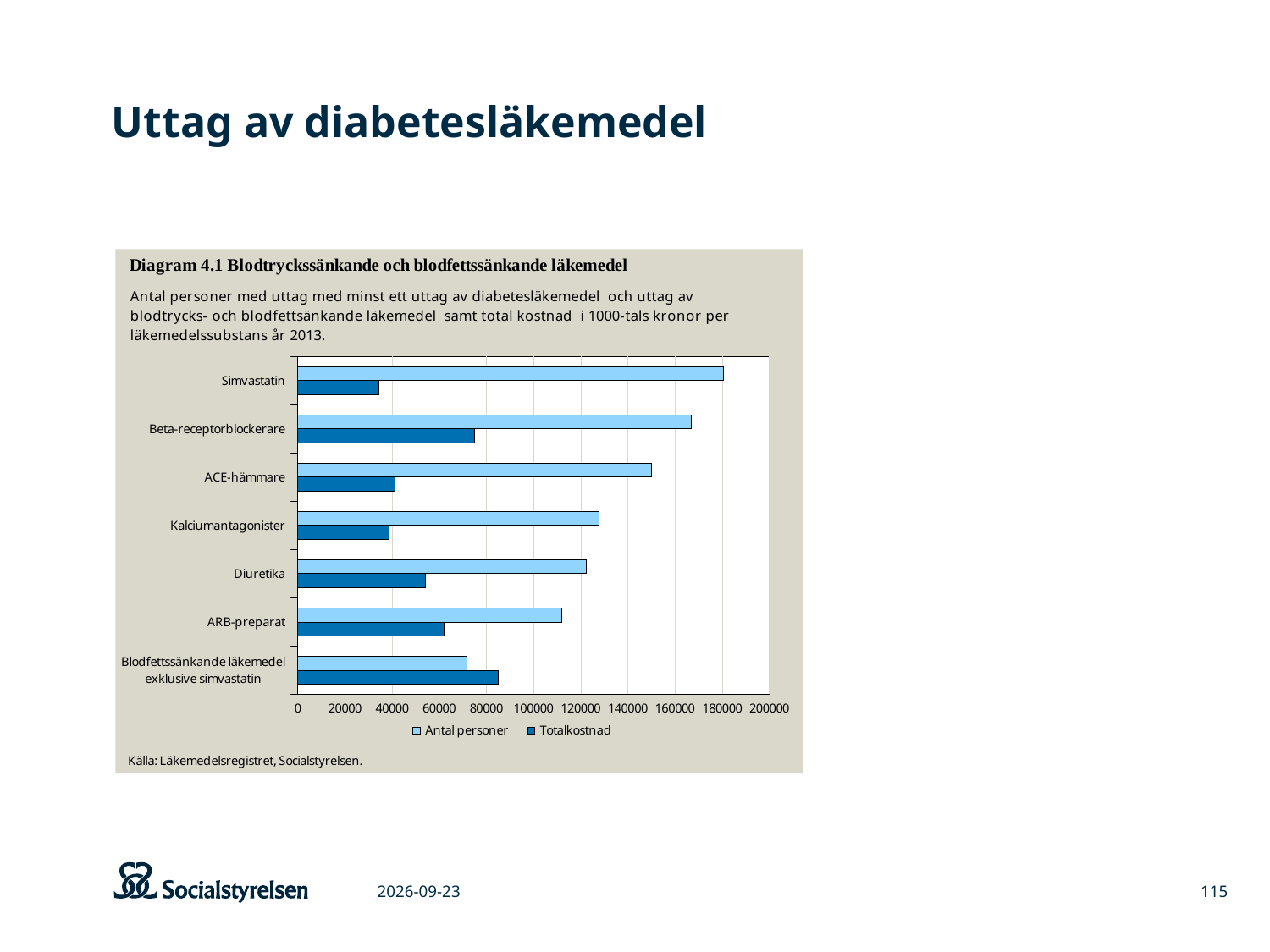
Is the Totalkostnad value for Beta-receptorblockerare greater or less than 60000? greater What kind of chart is shown on the slide? bar chart What are the two series named in the legend? Antal personer and Totalkostnad Is the Antal personer value for Simvastatin greater or less than 160000? greater How many series does the legend list? 2 How many categories are shown on the chart? 7 Which category has the lowest value for Antal personer? Blodfettssänkande läkemedel exklusive simvastatin Which category has the highest value for Totalkostnad? Blodfettssänkande läkemedel exklusive simvastatin Which category has the highest value for Antal personer? Simvastatin Which is larger for Antal personer: Simvastatin or Beta-receptorblockerare? Simvastatin Which is larger for Totalkostnad: ARB-preparat or ACE-hämmare? ARB-preparat Is the Totalkostnad value for Diuretika greater or less than 60000? less